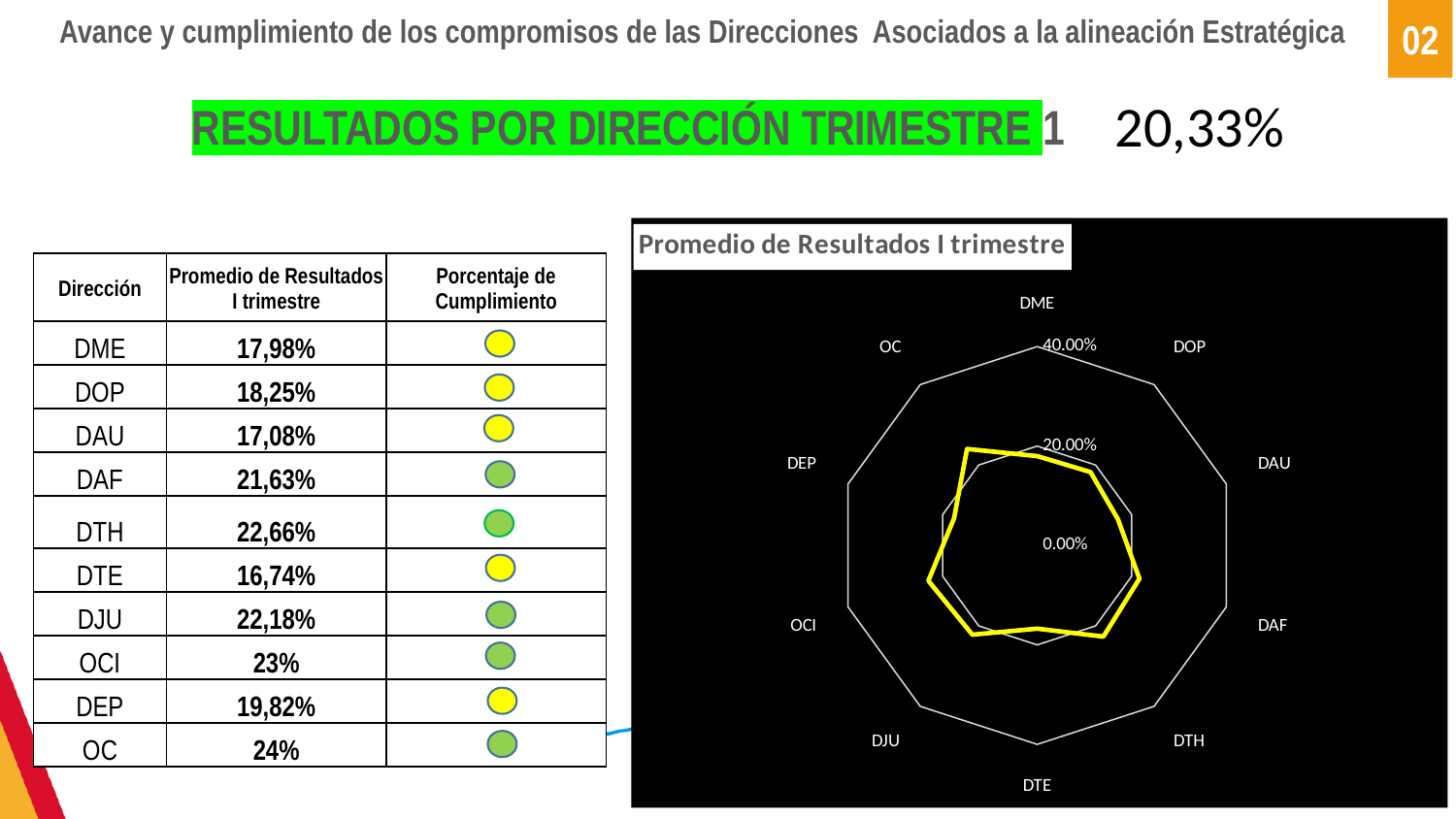
Is the value plotted for DAU greater or less than 20.00%? less According to the table on the slide, what is the Promedio de Resultados I trimestre for DTH? 22,66% Is the value plotted for DME greater or less than 40.00%? less Is the value plotted for DTE greater or less than 20.00%? less How many categories (direcciones) are plotted on the radar chart? 10 According to the table on the slide, which is larger, the value for DJU or the value for DTE? DJU What is the title of the chart? Promedio de Resultados I trimestre According to the table on the slide, what is the Promedio de Resultados I trimestre for OC? 24% What is the highest value shown on the radar chart's axis? 40.00% What kind of chart is shown on the slide? radar chart